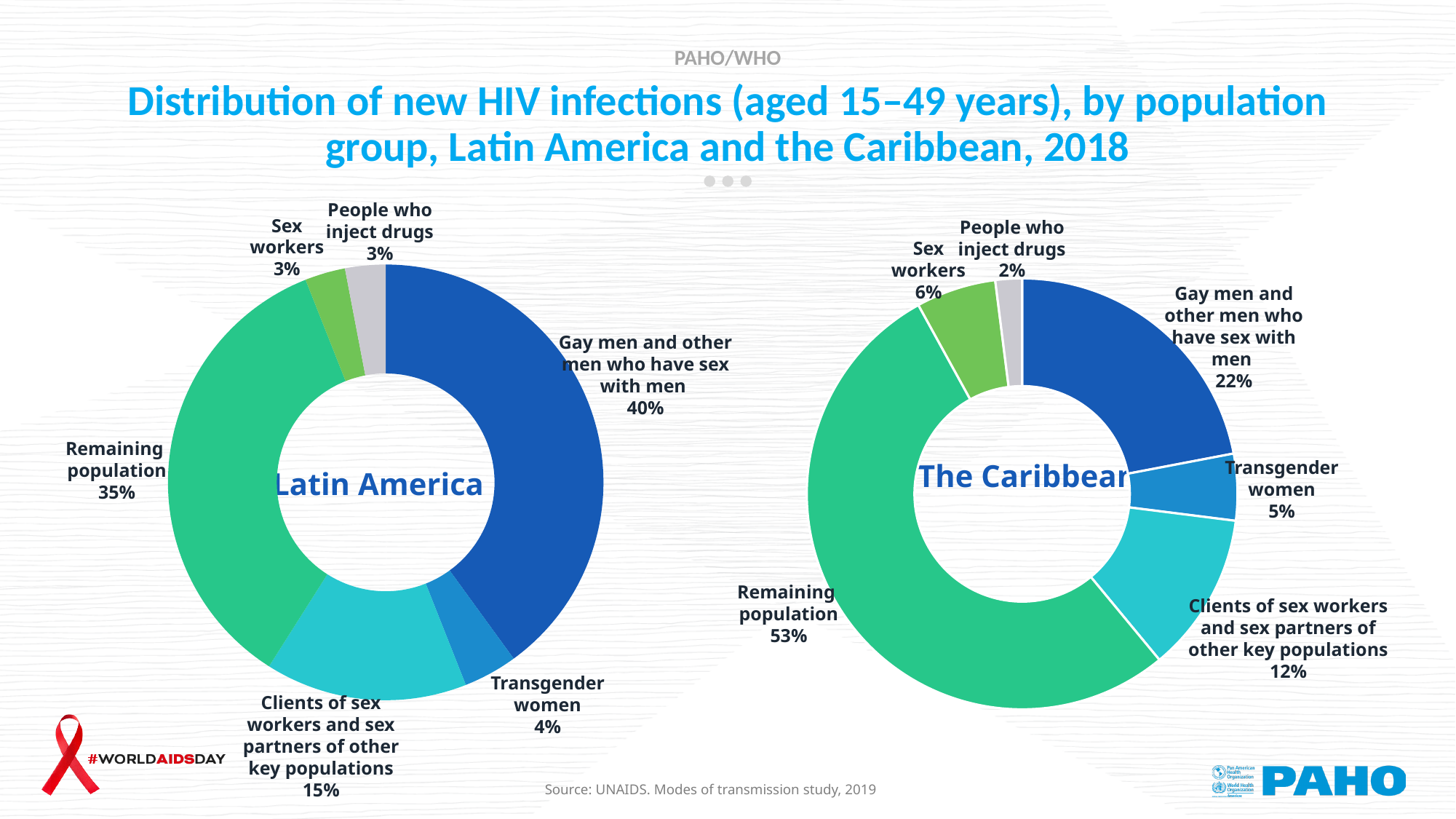
In the Caribbean chart, what share of new HIV infections is attributed to the remaining population? 53% How many population groups are shown in the Latin America chart? 6 What is the source cited for the data on the slide? UNAIDS. Modes of transmission study, 2019 Is the share for transgender women larger in the Latin America chart or the Caribbean chart? The Caribbean In the Latin America chart, which population group has the largest share? Gay men and other men who have sex with men In the Caribbean chart, which population group has the smallest share? People who inject drugs In the Caribbean chart, what share is attributed to sex workers? 6% In the Latin America chart, what share is attributed to clients of sex workers and sex partners of other key populations? 15% What is the difference between the share for gay men and other men who have sex with men in Latin America and in the Caribbean? 18% In the Caribbean chart, what is the combined share of sex workers and people who inject drugs? 8% In the Latin America chart, what share of new HIV infections is attributed to gay men and other men who have sex with men? 40% What kind of chart is used on this slide? Pie (doughnut) chart